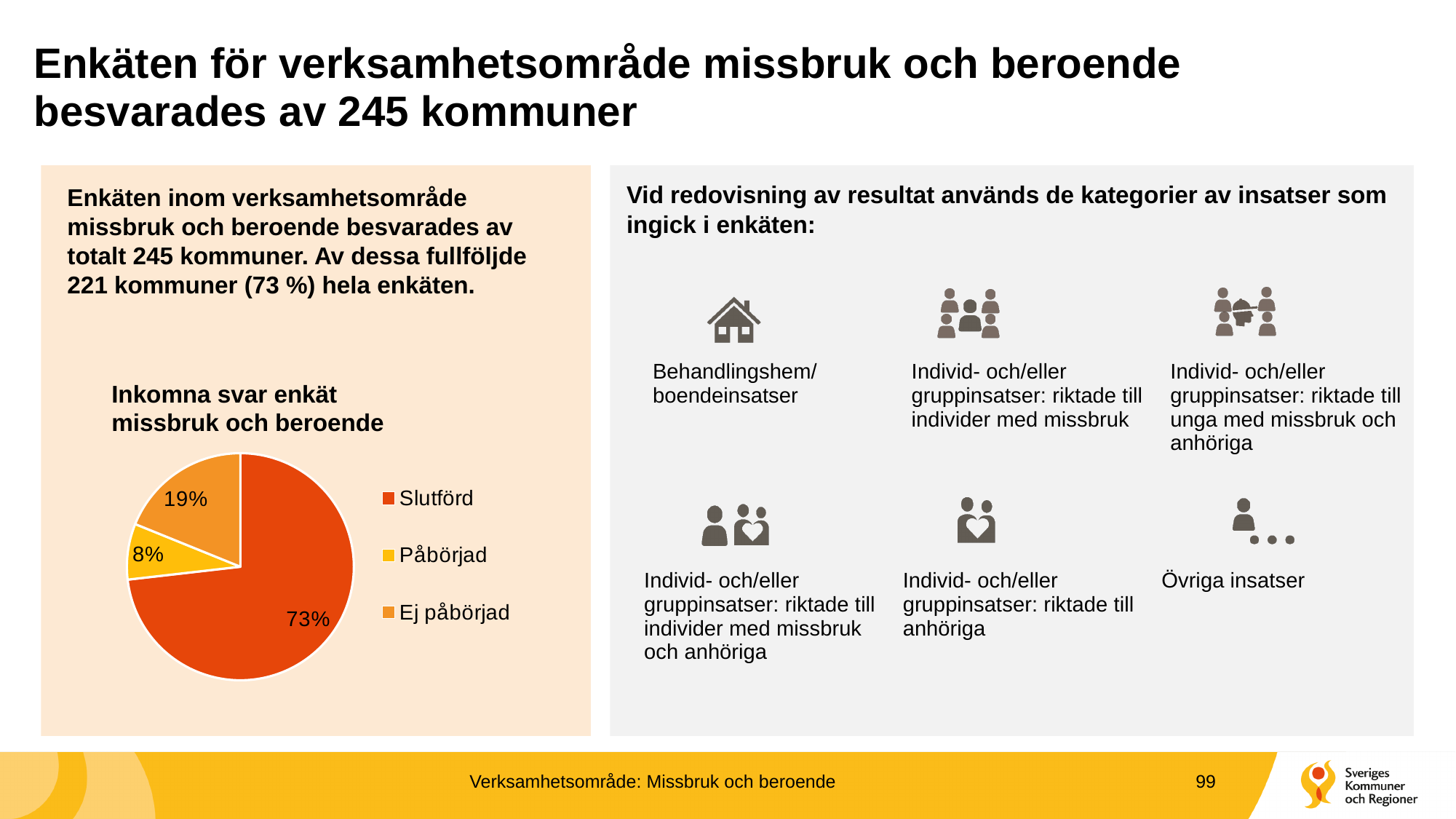
What share of the pie is Ej påbörjad? 19% What share of the pie is Slutförd? 73% What is the title of the pie chart? Inkomna svar enkät missbruk och beroende What is the difference in percentage points between Slutförd and Ej påbörjad? 54 Which category has the largest slice of the pie? Slutförd How many slices does the pie chart have? 3 Which is larger, Ej påbörjad or Påbörjad? Ej påbörjad What colour is the Påbörjad slice? yellow How many entries does the legend list? 3 What kind of chart is shown on the slide? pie chart Which category has the smallest slice of the pie? Påbörjad What share of the pie is Påbörjad? 8%